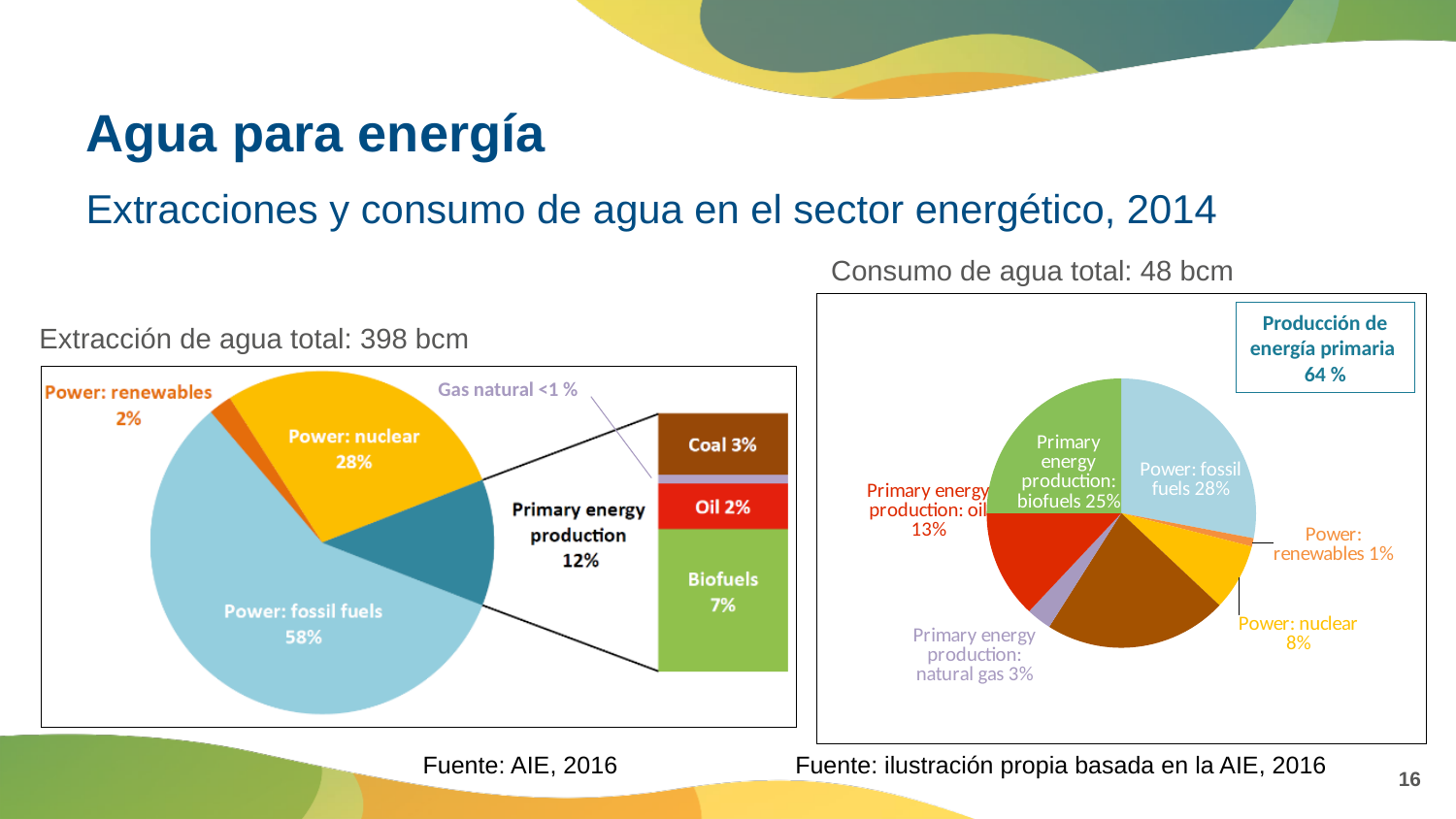
What type of chart is used on the right (Consumo de agua total: 48 bcm)? Pie chart In the left chart (Extracción de agua total: 398 bcm), what is the difference between Power: fossil fuels and Power: nuclear? 30 percentage points In the left chart (Extracción de agua total: 398 bcm), what share of the Primary energy production breakdown is Biofuels? 7% In the right chart (Consumo de agua total: 48 bcm), what share is Primary energy production: oil? 13% In the right chart (Consumo de agua total: 48 bcm), what share is Primary energy production: biofuels? 25% In the left chart (Extracción de agua total: 398 bcm), what share is Primary energy production? 12% In the left chart (Extracción de agua total: 398 bcm), what share is Power: fossil fuels? 58% In the right chart (Consumo de agua total: 48 bcm), what share is Power: nuclear? 8% In the left chart (Extracción de agua total: 398 bcm), what share is Power: nuclear? 28% In the right chart (Consumo de agua total: 48 bcm), which is larger: Power: fossil fuels or Primary energy production: natural gas? Power: fossil fuels In the right chart (Consumo de agua total: 48 bcm), what share does the box attribute to Producción de energía primaria? 64 % In the left chart (Extracción de agua total: 398 bcm), which category has the largest share? Power: fossil fuels